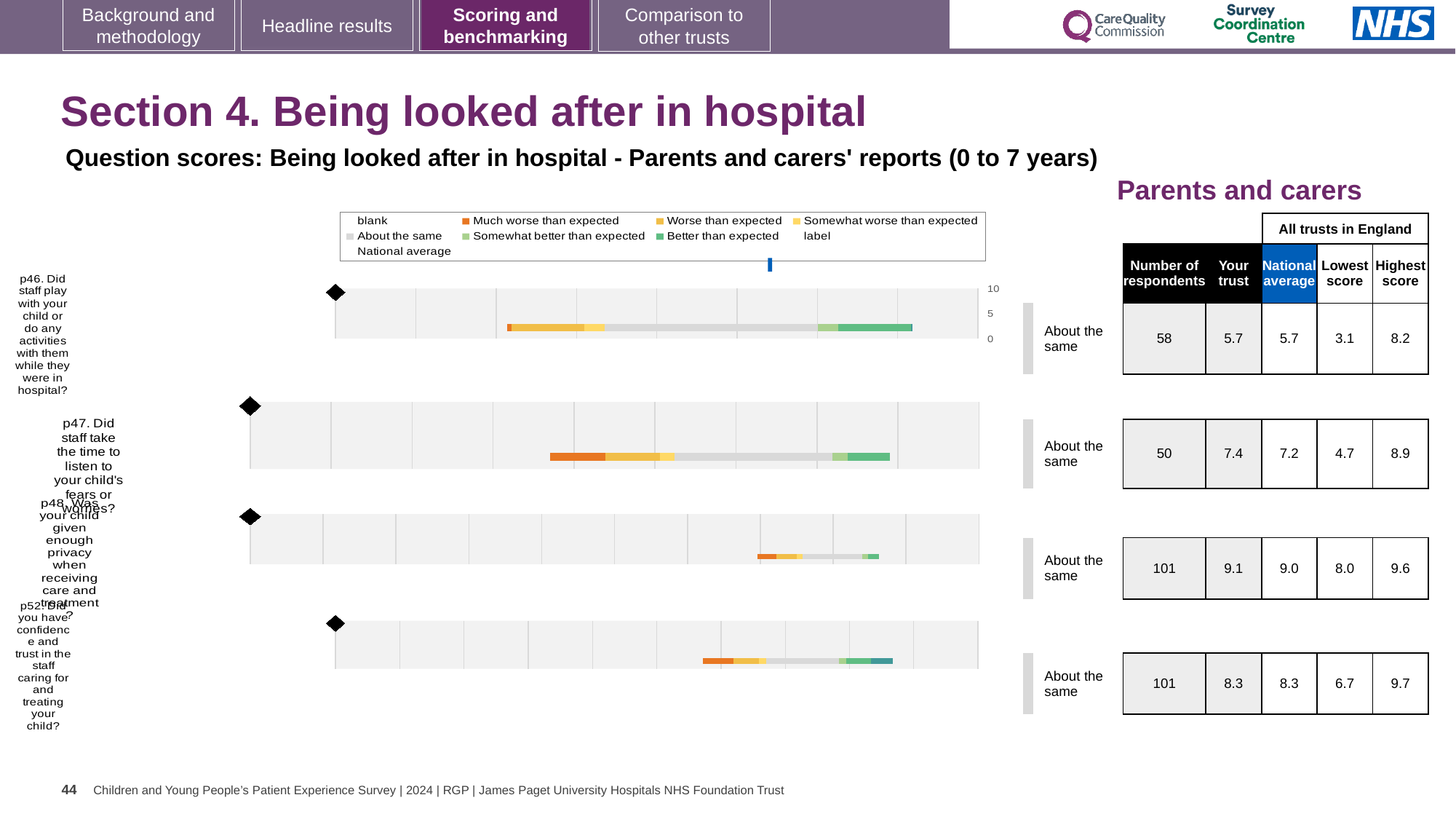
What is the national average for p48 (Was your child given enough privacy when receiving care and treatment?)? 9.0 How many respondents answered p46 (Did staff play with your child or do any activities with them while they were in hospital?)? 58 Which question has the highest 'Your trust' score? p48 For p47, is the 'Your trust' score higher or lower than the national average? higher What benchmark category is shown for all four questions on this slide? About the same What kind of chart is used to show the question scores? bar chart How many survey questions are plotted in the chart? 4 Which question has the lowest 'Your trust' score? p46 What is the difference between the highest score (8.9) and the lowest score (4.7) across all trusts for p47? 4.2 What is the title of the chart? Question scores: Being looked after in hospital - Parents and carers' reports (0 to 7 years) What is the lowest score across all trusts in England for p46? 3.1 What is the 'Your trust' score for p47 (Did staff take the time to listen to your child's fears or worries?)? 7.4